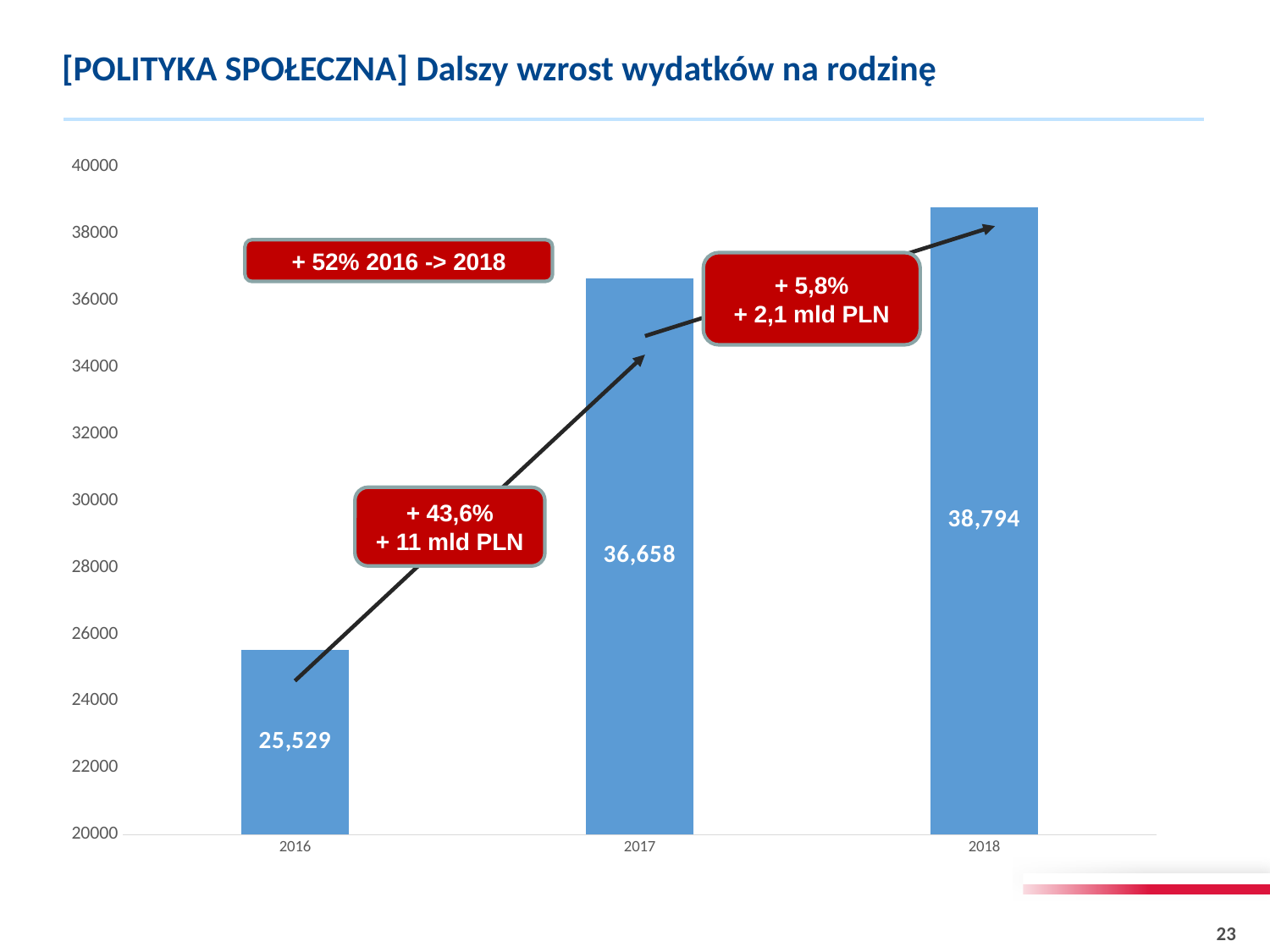
How many years are shown on the x axis? 3 Do the values rise or fall from 2016 to 2018? rise Which year has the lowest value? 2016 What kind of chart is shown on the slide? bar chart Which is larger, the value for 2017 or the value for 2018? 2018 What is the value shown for 2016? 25,529 What is the difference between the values for 2018 and 2017? 2,136 What is the value shown for 2018? 38,794 What is the value shown for 2017? 36,658 What is the difference between the values for 2017 and 2016? 11,129 Is the value for 2016 greater or less than 26000? less Which year has the highest value? 2018